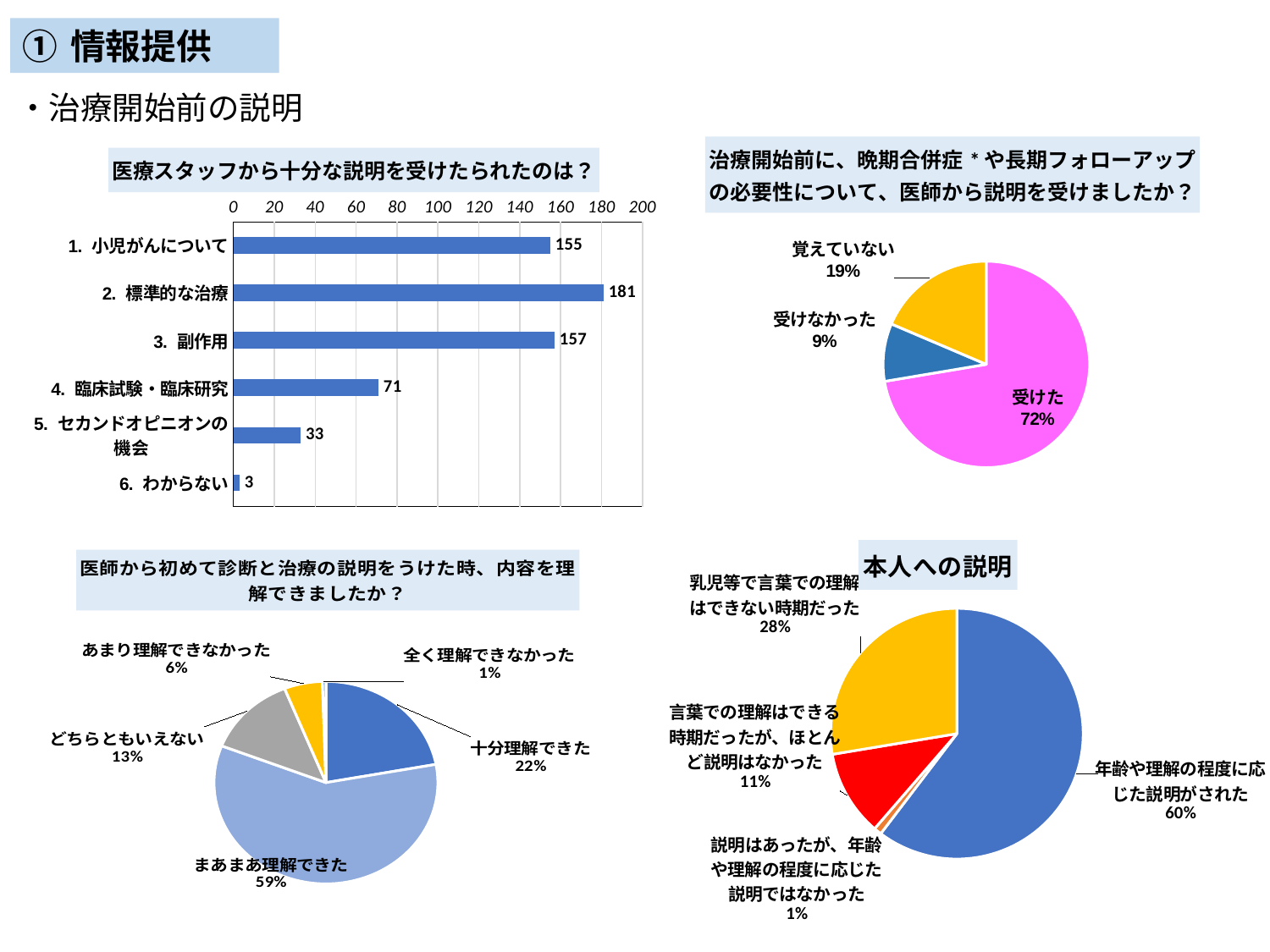
In the pie chart titled 「本人への説明」, which is larger: 「言葉での理解はできる時期だったが、ほとんど説明はなかった」 or 「乳児等で言葉での理解はできない時期だった」? 乳児等で言葉での理解はできない時期だった In the bar chart titled 「医療スタッフから十分な説明を受けたられたのは？」, how many categories are shown? 6 In the bar chart titled 「医療スタッフから十分な説明を受けたられたのは？」, which category has the highest value? 2. 標準的な治療 In the bar chart titled 「医療スタッフから十分な説明を受けたられたのは？」, which category has the lowest value? 6. わからない In the pie chart titled 「医師から初めて診断と治療の説明をうけた時、内容を理解できましたか？」, how many slices are there? 5 In the bar chart titled 「医療スタッフから十分な説明を受けたられたのは？」, what is the value for 「2. 標準的な治療」? 181 In the pie chart at the top right about 晩期合併症 and 長期フォローアップ, what share is 「受けた」? 72% In the bar chart titled 「医療スタッフから十分な説明を受けたられたのは？」, what is the difference between 「3. 副作用」 and 「4. 臨床試験・臨床研究」? 86 What kind of chart is the chart titled 「医療スタッフから十分な説明を受けたられたのは？」? bar chart In the pie chart at the top right about 晩期合併症 and 長期フォローアップ, which slice is the smallest? 受けなかった In the pie chart titled 「医師から初めて診断と治療の説明をうけた時、内容を理解できましたか？」, what share is 「まあまあ理解できた」? 59% In the pie chart titled 「本人への説明」, what share is 「乳児等で言葉での理解はできない時期だった」? 28%